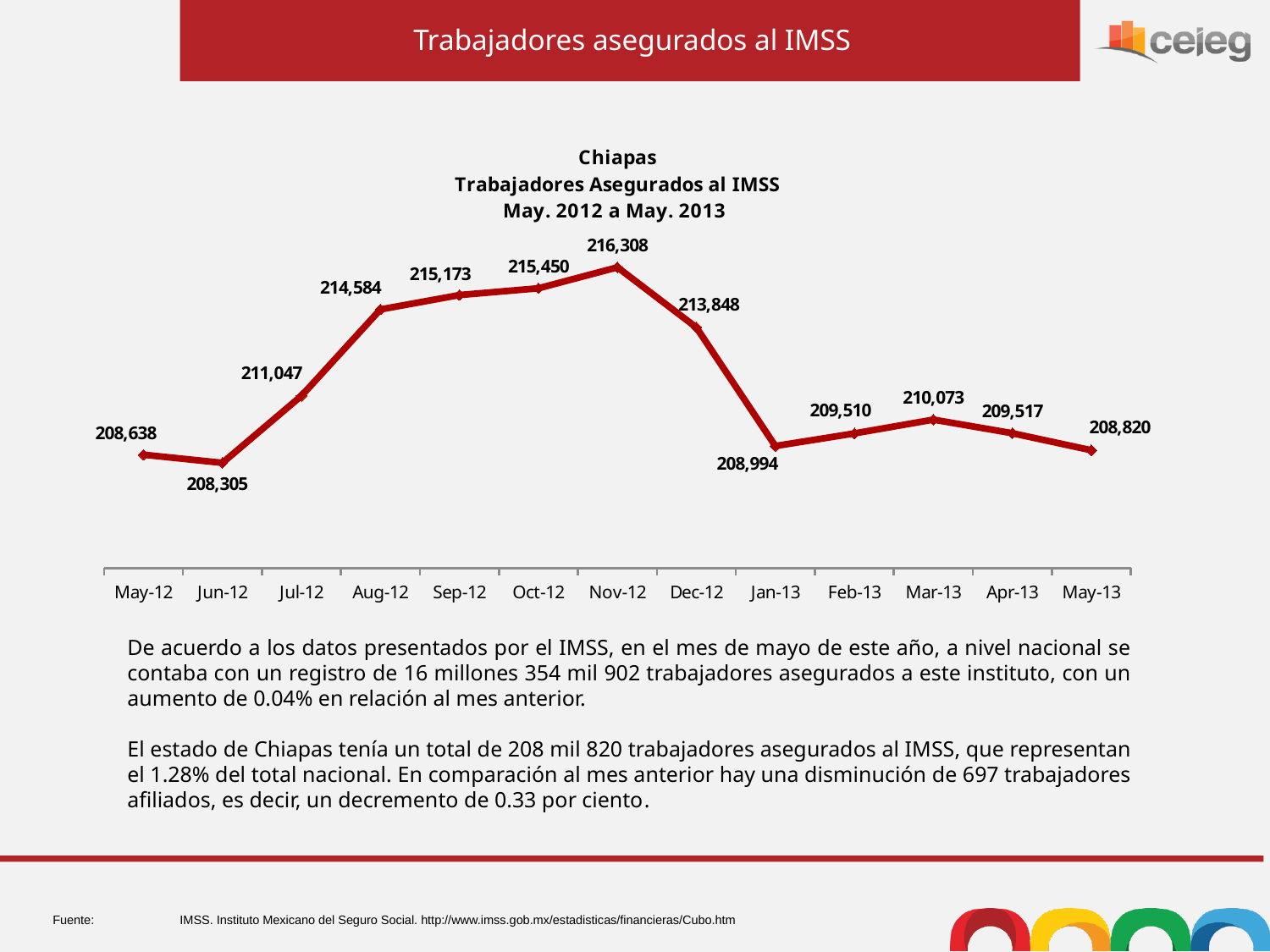
What is the value for May-13? 208,820 Which is larger, the value for Jul-12 or the value for Dec-12? Dec-12 Which month has the lowest value? Jun-12 What kind of chart is shown? line chart What is the difference between the values for Nov-12 and Jun-12? 8,003 How many months are plotted on the chart? 13 Do the values rise or fall from Jul-12 to Nov-12? rise What is the value for Jan-13? 208,994 What is the difference between the values for Apr-13 and May-13? 697 Which month has the highest value? Nov-12 What is the value for Nov-12? 216,308 What is the title of the chart? Chiapas Trabajadores Asegurados al IMSS May. 2012 a May. 2013